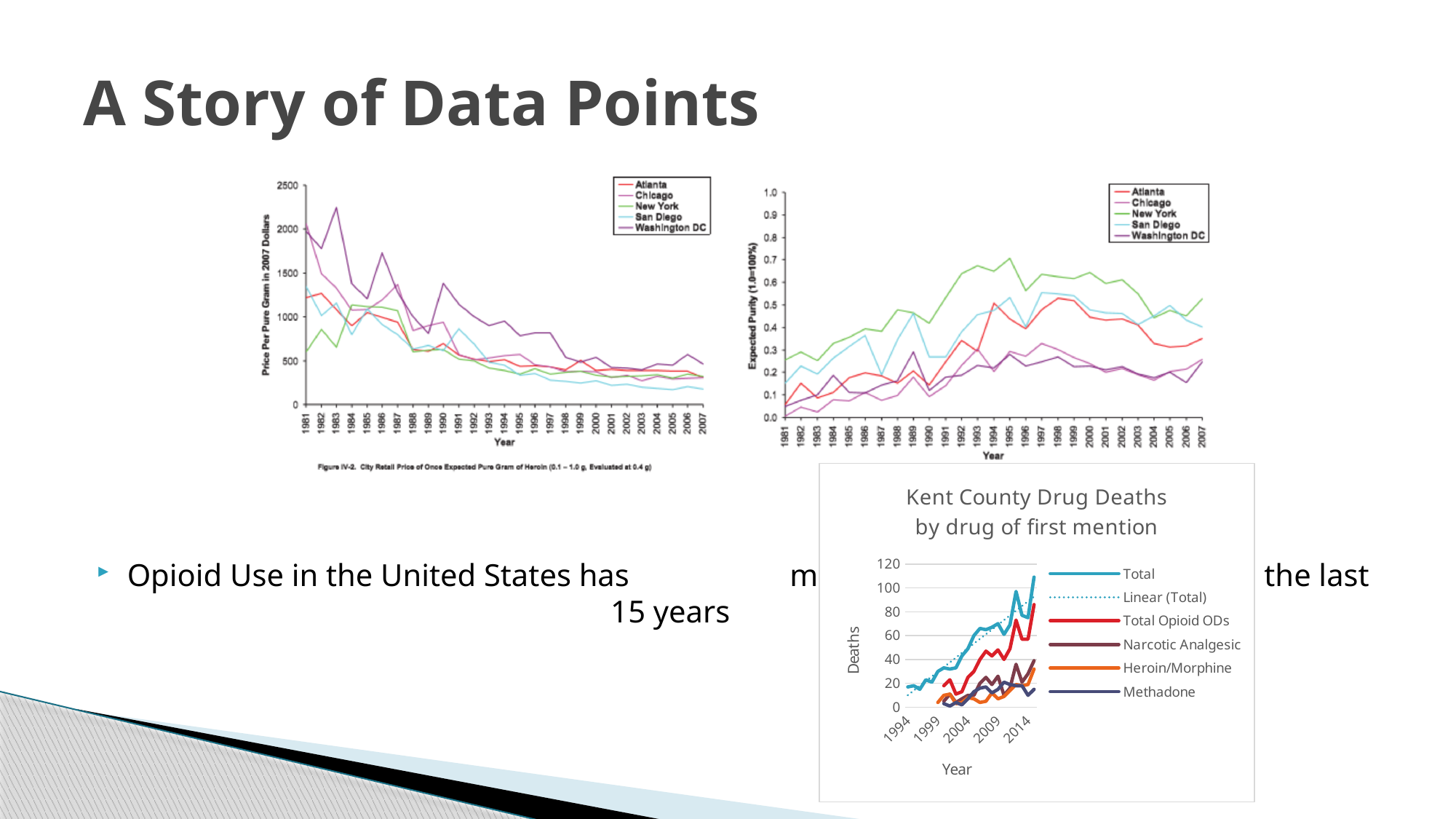
What type of chart is the 'Kent County Drug Deaths by drug of first mention' chart? line chart In the top-left chart (Price Per Pure Gram in 2007 Dollars), do the prices generally rise or fall from 1981 to 2007? fall How many cities does the legend of the top-left chart (Price Per Pure Gram in 2007 Dollars) list? 5 In the top-left chart (Price Per Pure Gram in 2007 Dollars), which city has the highest value in 1983? Washington DC In the 'Kent County Drug Deaths by drug of first mention' chart, which is larger in 2014: Total Opioid ODs or Methadone? Total Opioid ODs In the top-left chart (Price Per Pure Gram in 2007 Dollars), is the value for Washington DC in 1983 greater or less than 2000? greater In the 'Kent County Drug Deaths by drug of first mention' chart, does the Total series rise or fall over the years shown? rise In the 'Kent County Drug Deaths by drug of first mention' chart, which series has the highest value in 2014? Total How many series does the legend of the 'Kent County Drug Deaths by drug of first mention' chart list? 6 In the top-right chart (Expected Purity), is the value for New York in 1995 greater or less than 0.6? greater What is the y-axis label of the 'Kent County Drug Deaths by drug of first mention' chart? Deaths In the 'Kent County Drug Deaths by drug of first mention' chart, is the Total value in 2014 greater or less than 100? less